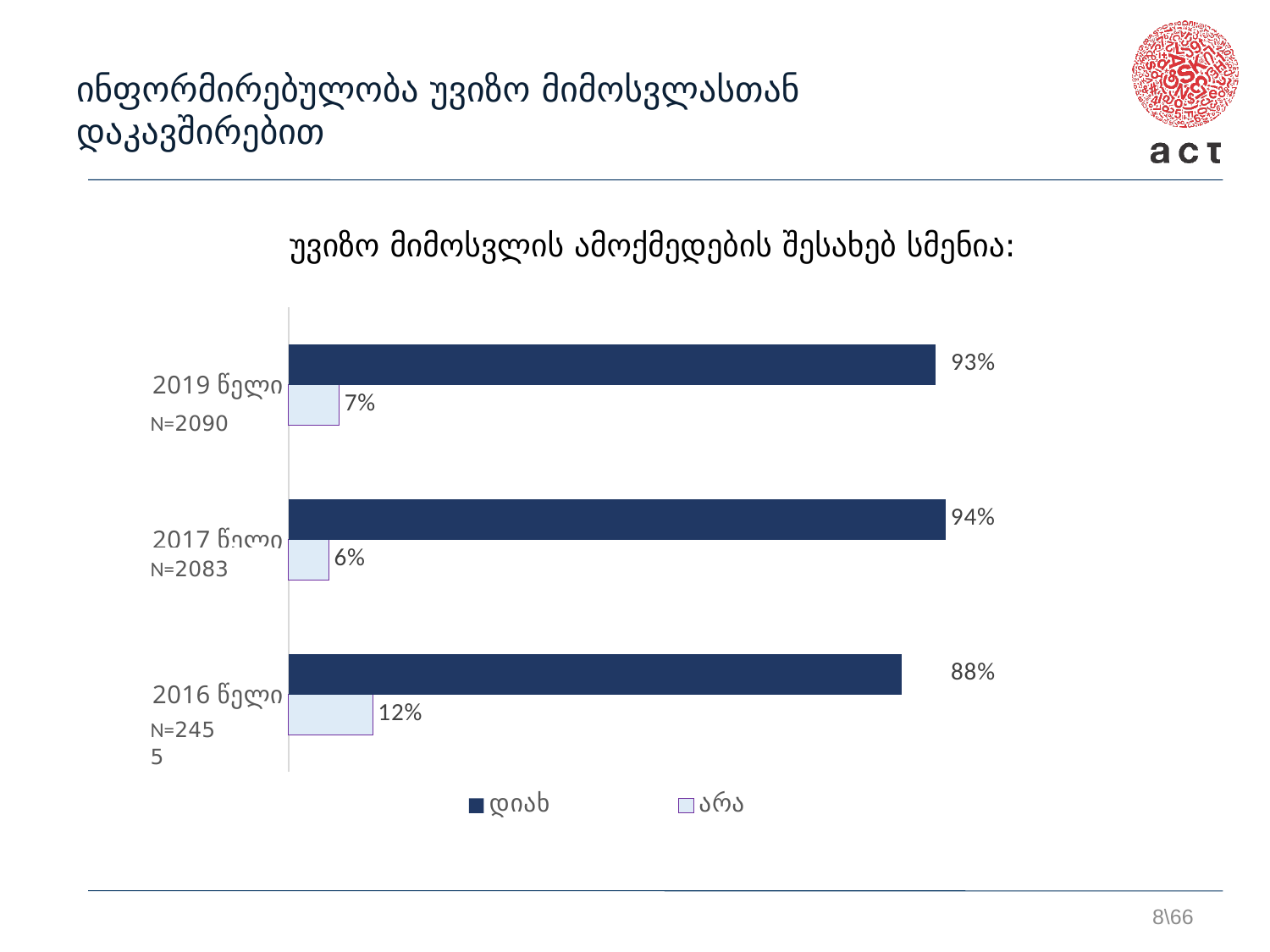
How many series does the legend list? 2 What kind of chart is shown on the slide? bar chart Which year has the highest value for დიახ? 2017 წელი What is the difference between the დიახ values for 2017 წელი and 2016 წელი? 6% What is the value for არა in 2016 წელი? 12% What is the value for არა in 2017 წელი? 6% What is the value for დიახ in 2019 წელი? 93% What is the sample size (N) shown for 2019 წელი? N=2090 How many years are shown on the chart? 3 Which year has the lowest value for დიახ? 2016 წელი What is the value for დიახ in 2017 წელი? 94% Which is larger, the არა value for 2019 წელი or for 2016 წელი? 2016 წელი